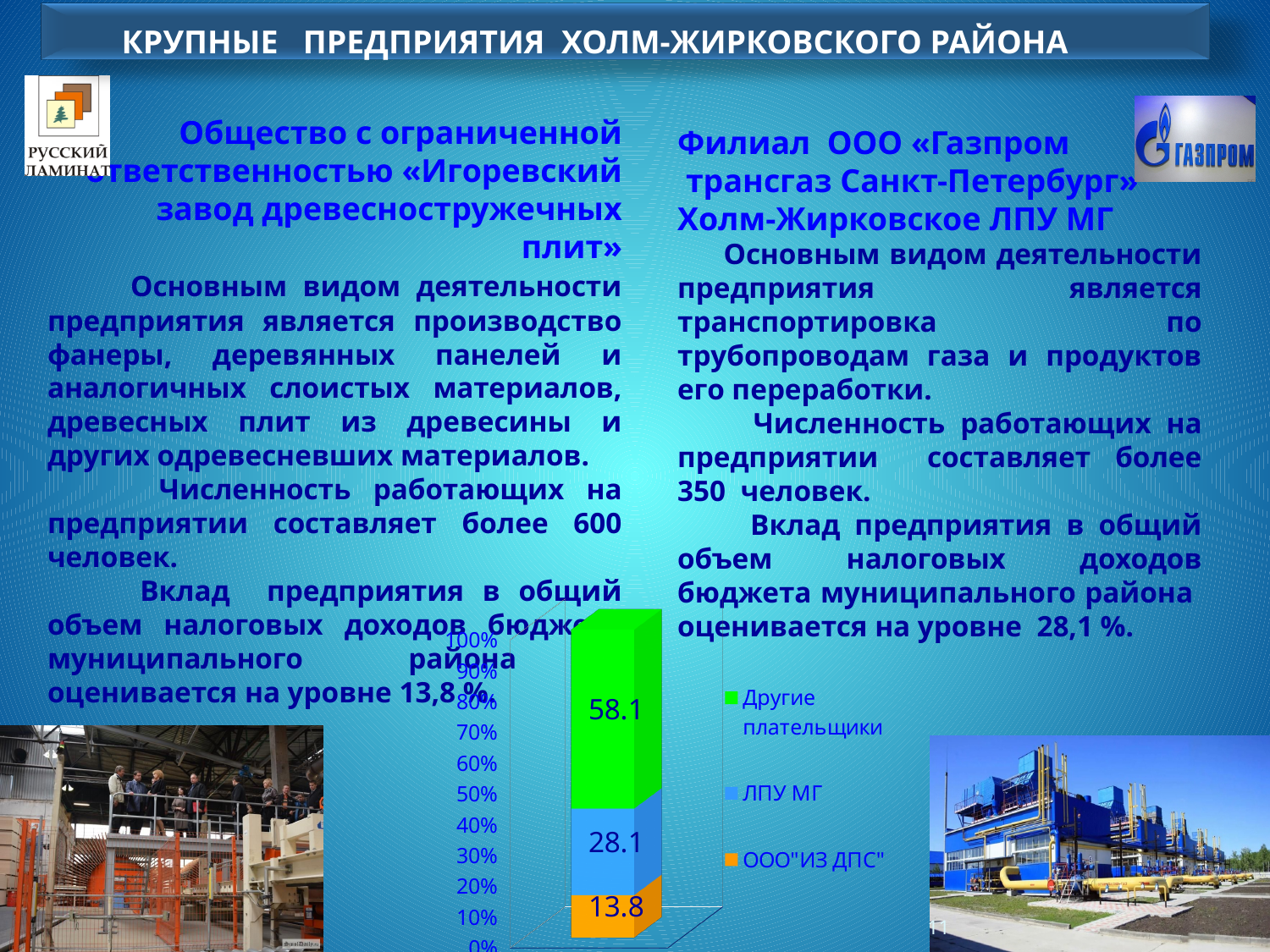
What kind of chart is shown on the slide? stacked bar chart What is the value of the ЛПУ МГ segment in the stacked bar? 28.1 Which is larger, the ЛПУ МГ segment or the ООО"ИЗ ДПС" segment? ЛПУ МГ What is the difference between the ЛПУ МГ segment and the ООО"ИЗ ДПС" segment? 14.3 What is the value of the ООО"ИЗ ДПС" segment in the stacked bar? 13.8 What is the difference between the Другие плательщики segment and the ЛПУ МГ segment? 30.0 How many series does the chart legend list? 3 Which series has the largest segment in the stacked bar? Другие плательщики What colour is the Другие плательщики segment in the chart? green What is the total of the three segments in the stacked bar? 100.0 What is the value of the Другие плательщики segment in the stacked bar? 58.1 Which series has the smallest segment in the stacked bar? ООО"ИЗ ДПС"